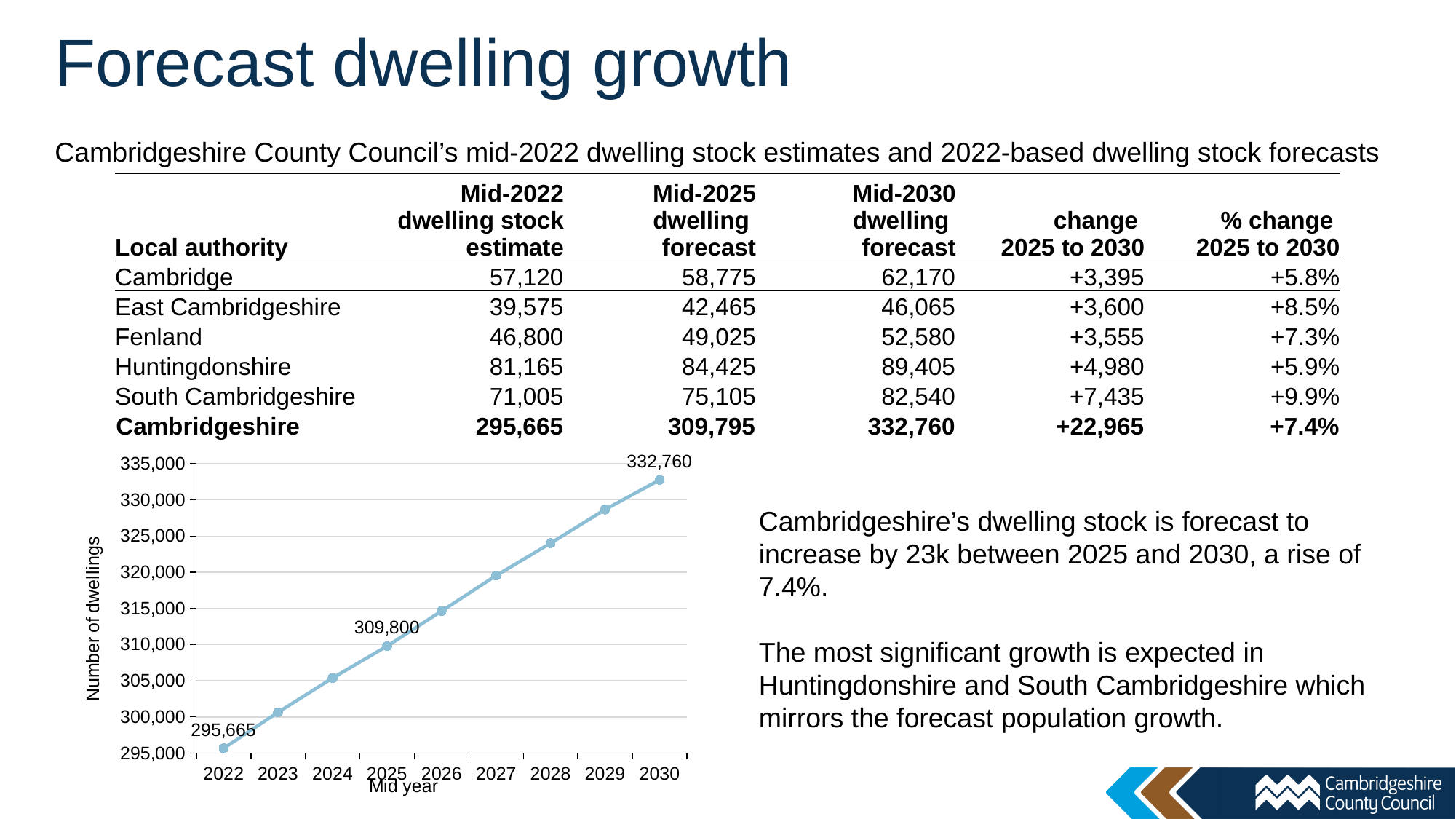
What is the label on the y axis of the chart? Number of dwellings What is the number of dwellings shown for mid-2022 on the chart? 295,665 What is the number of dwellings shown for mid-2025 on the chart? 309,800 What is the difference between the labelled values for 2030 and 2025 on the chart? 22,960 What type of chart is shown on the slide? line chart How many years are plotted on the x axis of the chart? 9 Which year has the lowest number of dwellings on the chart? 2022 Which year has the highest number of dwellings on the chart? 2030 What is the number of dwellings shown for mid-2030 on the chart? 332,760 Do the values on the chart rise or fall from 2022 to 2030? rise Is the value for 2027 on the chart greater or less than 315,000? greater Is the value for 2023 on the chart greater or less than 305,000? less